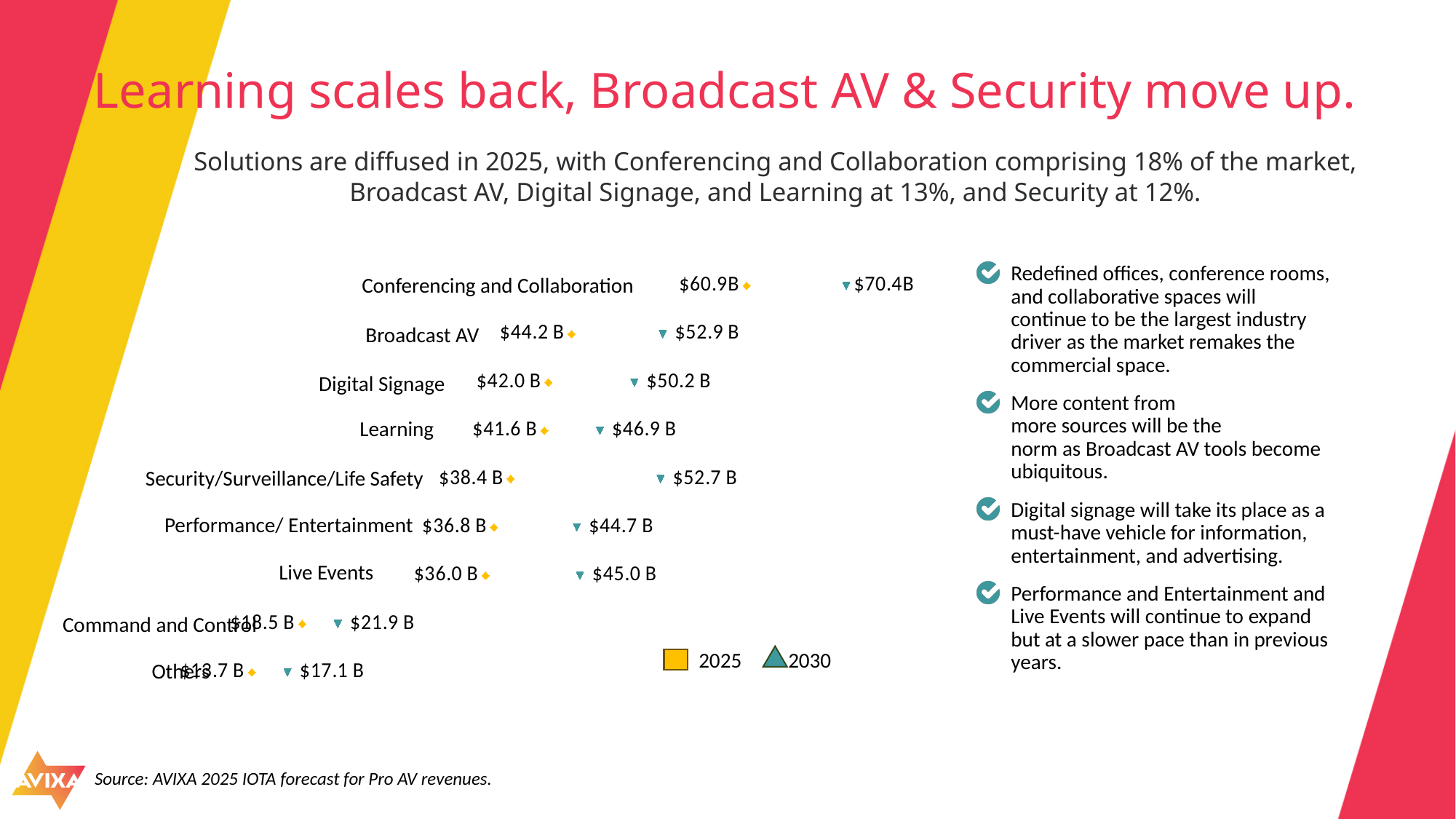
What is the 2030 value for Live Events? $45.0 B What is the 2025 value for Command and Control? $18.5 B How many categories are shown in the chart? 9 What is the 2025 value for Digital Signage? $42.0 B What is the 2030 value for Security/Surveillance/Life Safety? $52.7 B What is the difference between the 2030 and 2025 values for Security/Surveillance/Life Safety? $14.3 B Which category has the lowest 2025 value? Others How many series does the legend list? 2 Which category has the highest 2030 value? Conferencing and Collaboration Which has the larger 2030 value, Broadcast AV or Learning? Broadcast AV Which marker shape represents 2030 in the legend? Triangle What is the 2025 value for Conferencing and Collaboration? $60.9B